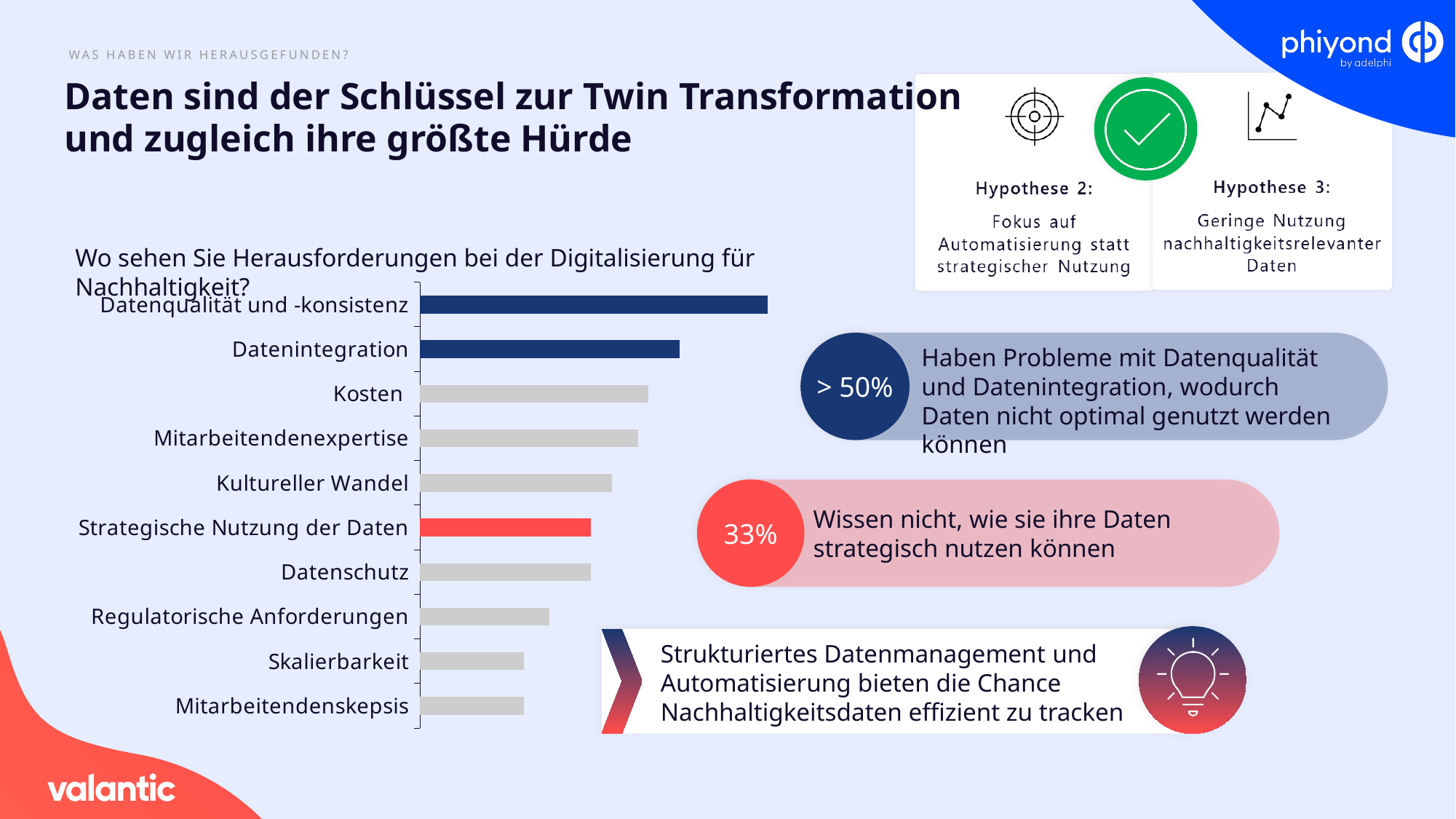
How many categories does the bar chart show? 10 Which category's bar is coloured red in the chart? Strategische Nutzung der Daten Which bar is longer: Strategische Nutzung der Daten or Skalierbarkeit? Strategische Nutzung der Daten What question is the bar chart titled with? Wo sehen Sie Herausforderungen bei der Digitalisierung für Nachhaltigkeit? Which bar is longer: Datenschutz or Regulatorische Anforderungen? Datenschutz Which category has the longest bar in the chart? Datenqualität und -konsistenz Which bar is longer: Datenqualität und -konsistenz or Mitarbeitendenexpertise? Datenqualität und -konsistenz What kind of chart is shown on the slide? bar chart Which category has the second-longest bar in the chart? Datenintegration